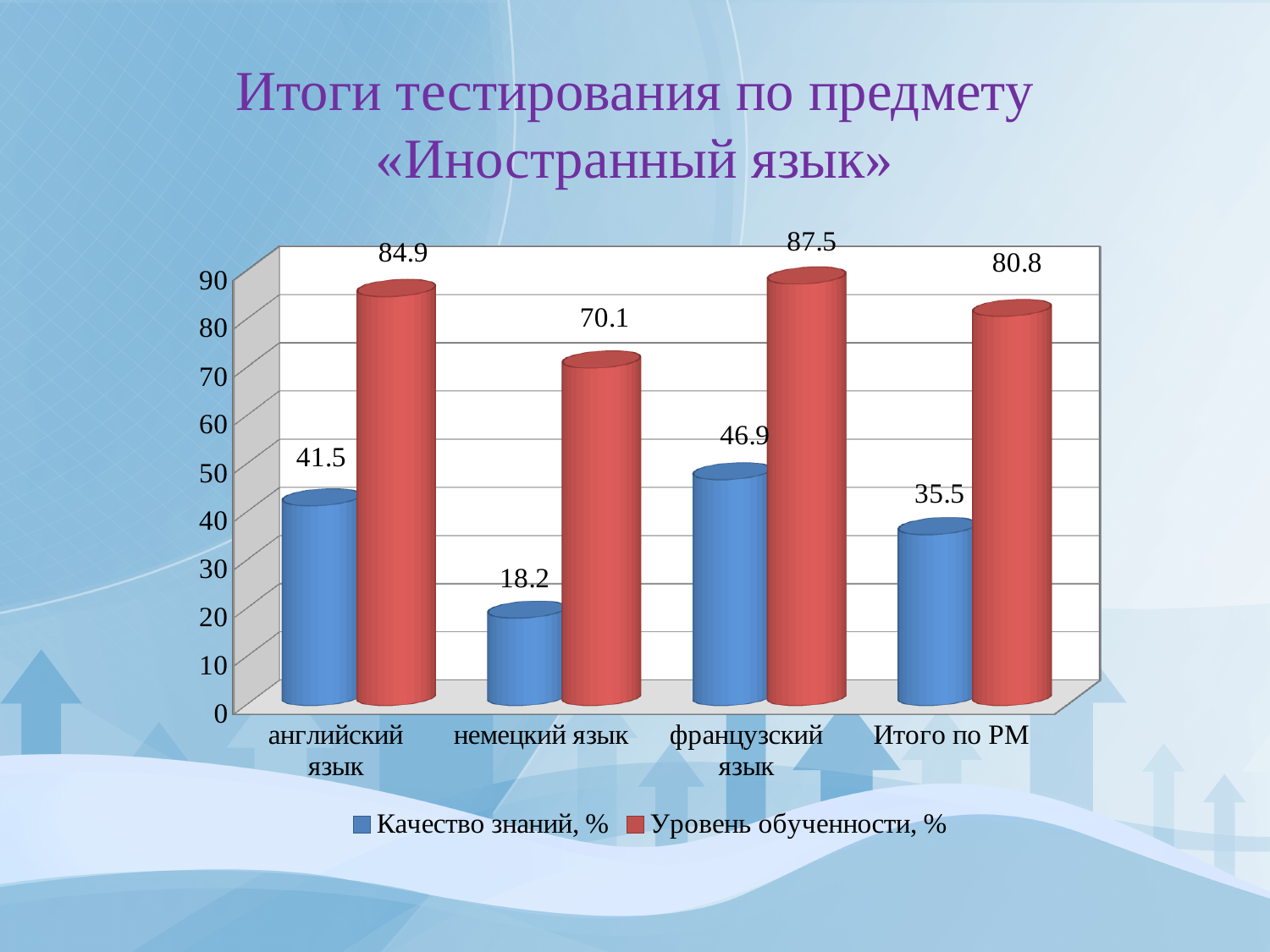
What is the difference in Качество знаний, % between английский язык and немецкий язык? 23.3 What is the difference between Уровень обученности, % and Качество знаний, % for французский язык? 40.6 Which category has the highest value for Уровень обученности, %? французский язык What is the value of Уровень обученности, % for Итого по РМ? 80.8 Which is larger: Качество знаний, % for английский язык or for французский язык? французский язык Which category has the lowest value for Качество знаний, %? немецкий язык What is the value of Качество знаний, % for английский язык? 41.5 What colour are the bars for Уровень обученности, %? red How many series does the legend list? 2 How many categories are shown on the x axis? 4 What kind of chart is shown on the slide? bar chart What is the value of Уровень обученности, % for немецкий язык? 70.1